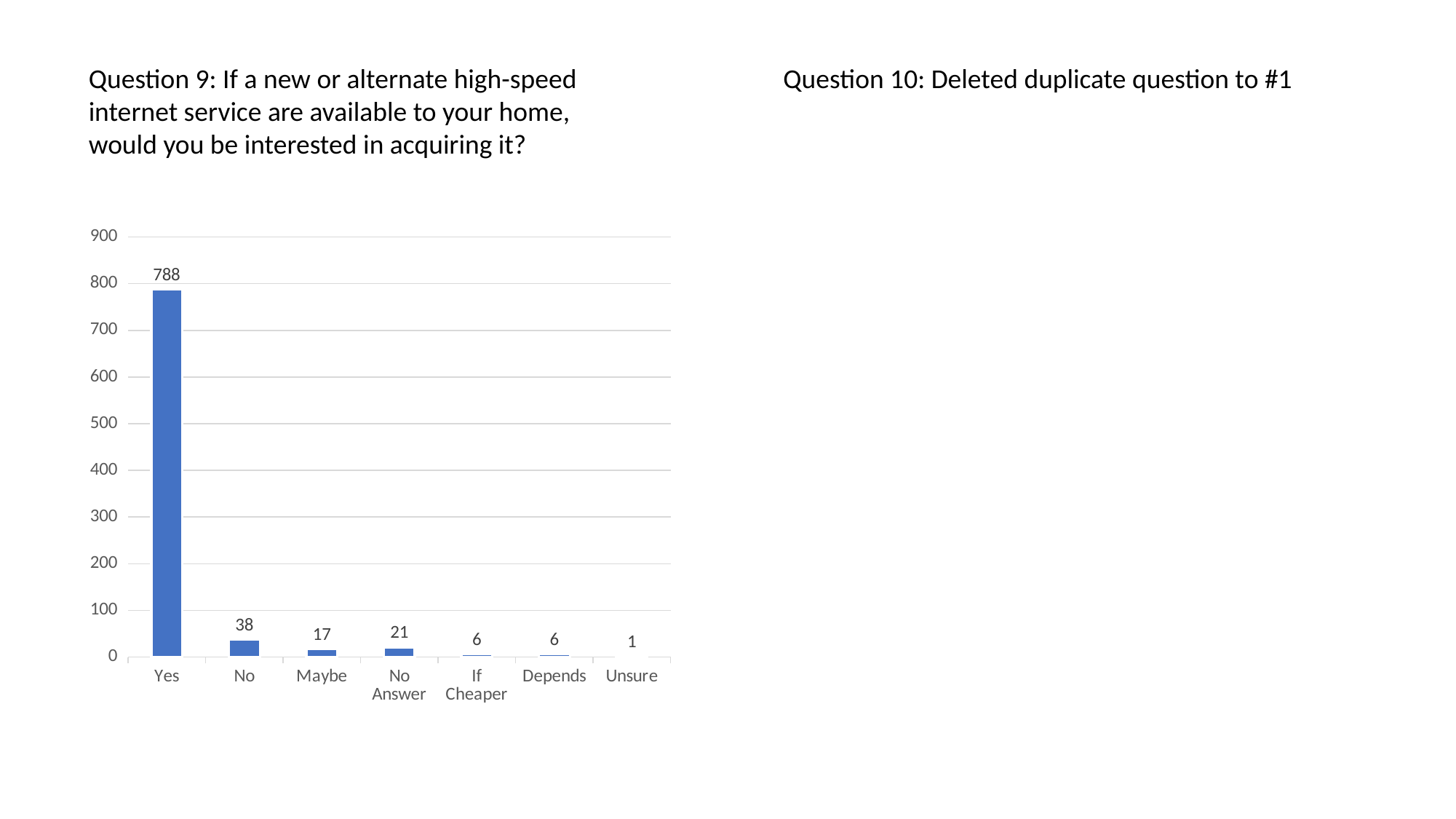
What kind of chart is shown on the slide? bar chart What is the value for Yes? 788 Which is larger, the value for No Answer or the value for Maybe? No Answer How many categories are shown on the x axis? 7 What is the value for No? 38 Is the value for Yes greater or less than 700? greater What is the difference between the values for No and Maybe? 21 What is the value for Unsure? 1 What is the value for No Answer? 21 Which category has the highest value? Yes What is the difference between the values for Yes and No? 750 Which category has the lowest value? Unsure